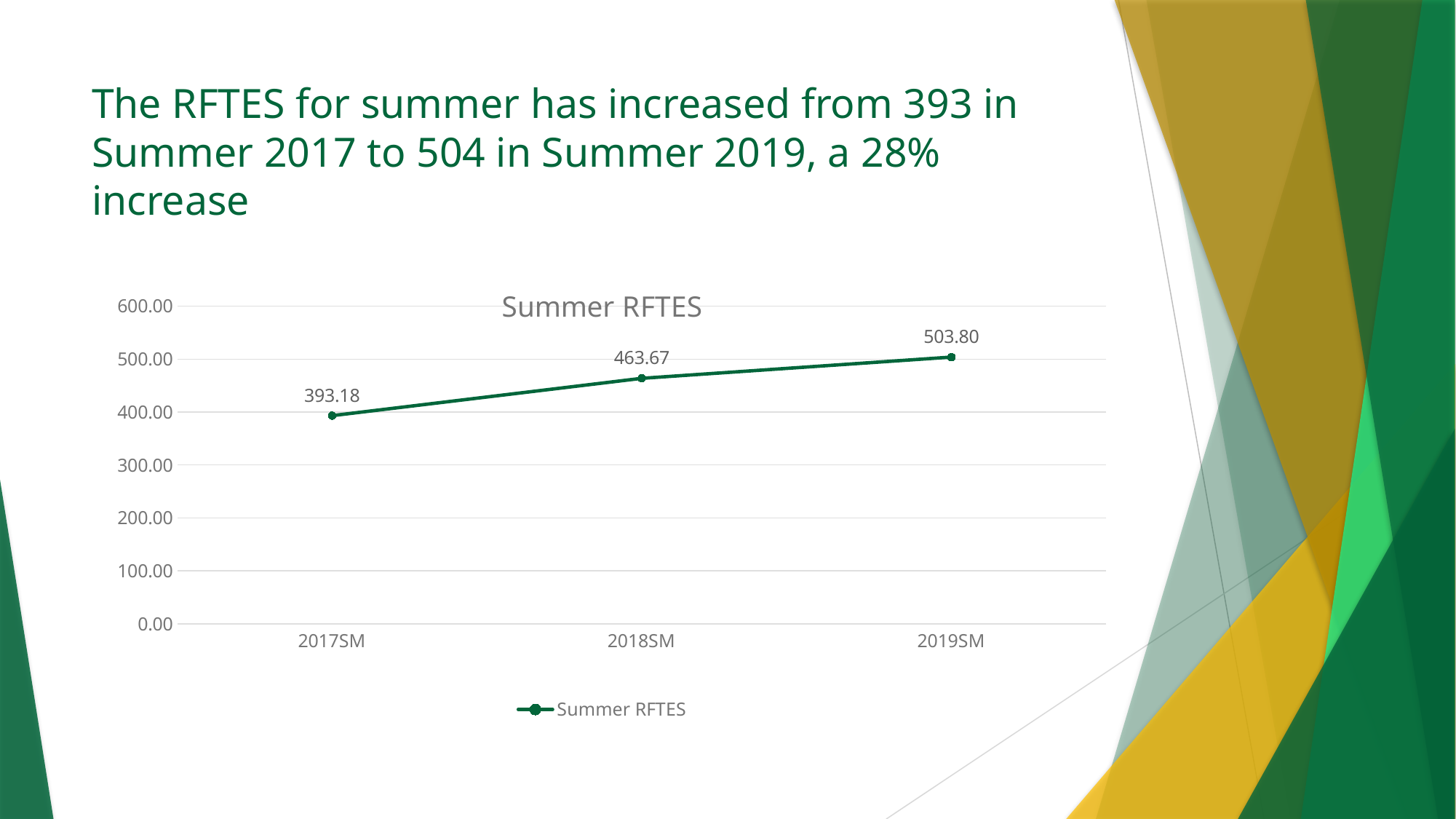
What is the Summer RFTES value for 2017SM? 393.18 What is the Summer RFTES value for 2018SM? 463.67 Which period has the highest Summer RFTES value? 2019SM What is the difference between the Summer RFTES values for 2018SM and 2017SM? 70.49 What kind of chart is shown on the slide? line chart Is the Summer RFTES value for 2019SM greater or less than 500.00? greater Do the Summer RFTES values rise or fall from 2017SM to 2019SM? rise What is the Summer RFTES value for 2019SM? 503.80 Which period has the lowest Summer RFTES value? 2017SM What is the difference between the Summer RFTES values for 2019SM and 2017SM? 110.62 How many periods are plotted on the x axis of the chart? 3 Which is larger, the Summer RFTES value for 2018SM or for 2019SM? 2019SM